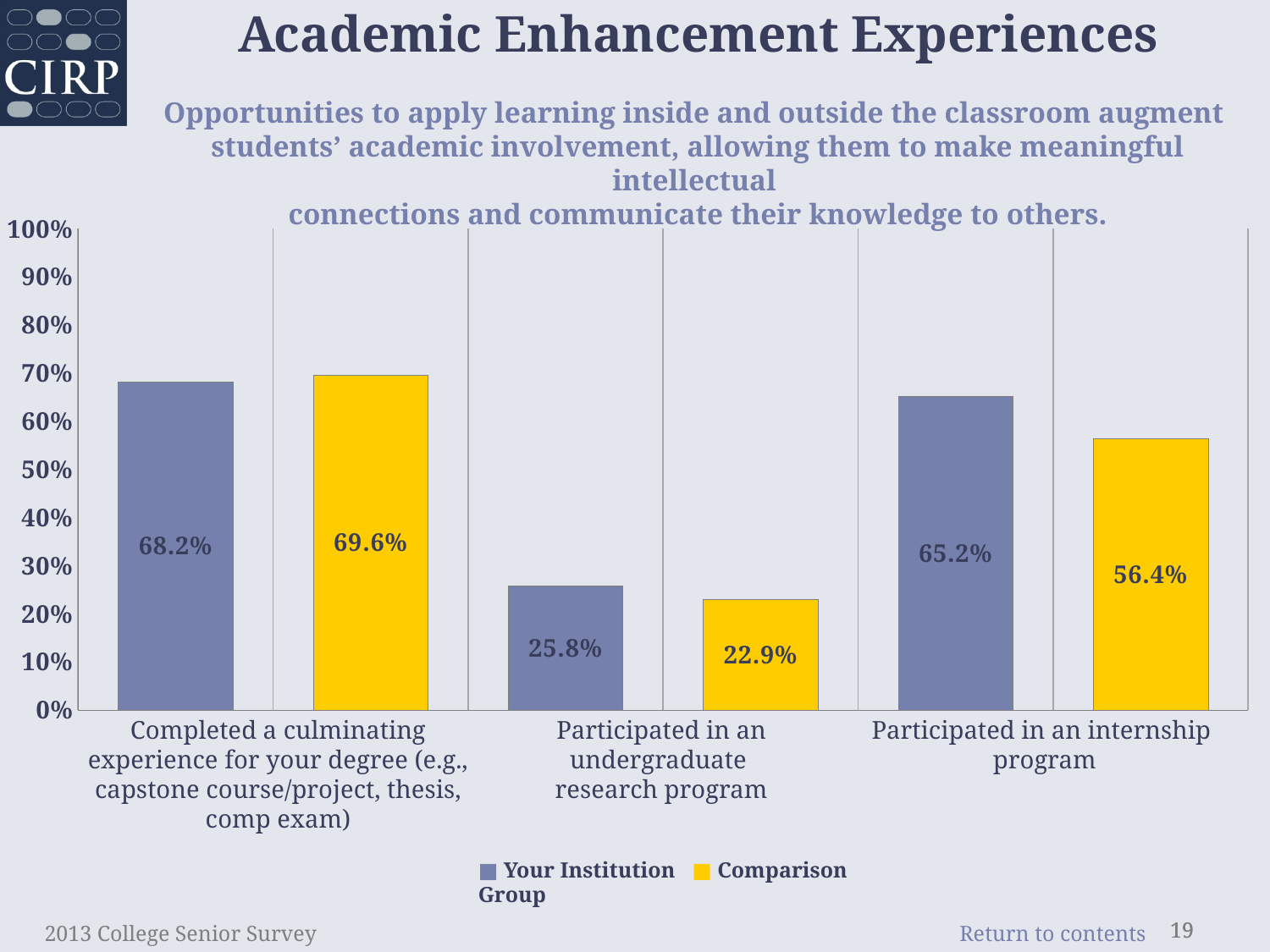
What is the value for Comparison Group for 'Completed a culminating experience for your degree'? 69.6% What kind of chart is shown on the slide? Bar chart For 'Participated in an undergraduate research program', which is larger: Your Institution or Comparison Group? Your Institution Which category has the lowest value for Your Institution? Participated in an undergraduate research program Is the value for Your Institution for 'Participated in an internship program' greater or less than 60%? greater How many categories are shown on the x axis? 3 What is the value for Comparison Group for 'Participated in an internship program'? 56.4% What is the title of the slide's chart? Academic Enhancement Experiences What is the value for Your Institution for 'Participated in an undergraduate research program'? 25.8% How many series does the legend list? 2 What is the difference between Your Institution and Comparison Group for 'Participated in an internship program'? 8.8% Which category has the highest value for Comparison Group? Completed a culminating experience for your degree (e.g., capstone course/project, thesis, comp exam)